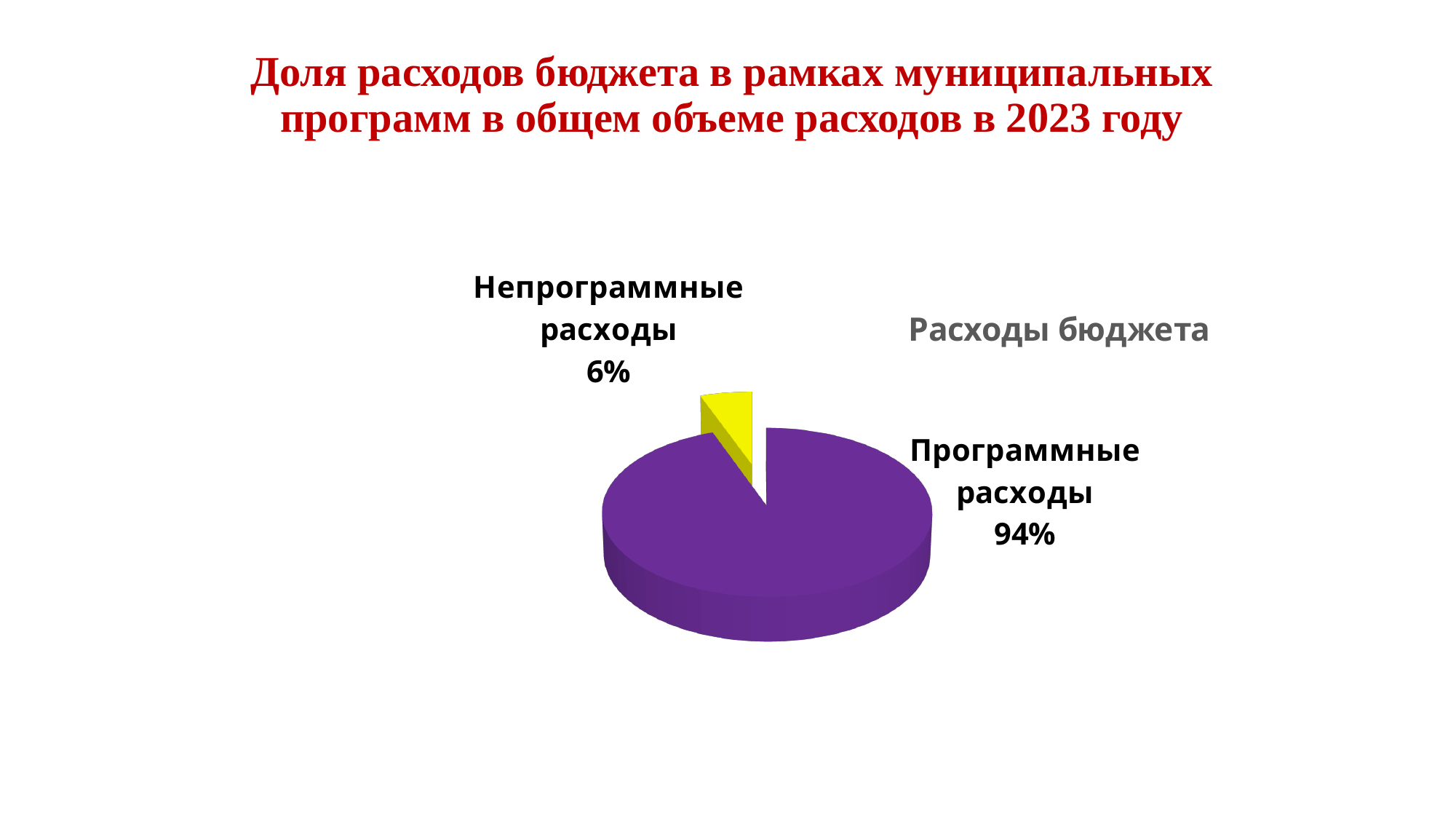
What is the total of the two slices shown in the pie chart? 100% Which slice of the pie is the largest? Программные расходы What share of the pie is labelled "Непрограммные расходы"? 6% How many slices does the pie chart have? 2 What colour is the slice for "Непрограммные расходы"? Yellow Which slice of the pie is the smallest? Непрограммные расходы What type of chart is shown on the slide? Pie chart Which is larger: the share for "Программные расходы" or the share for "Непрограммные расходы"? Программные расходы What share of the pie is labelled "Программные расходы"? 94% What is the difference in percentage points between "Программные расходы" and "Непрограммные расходы"? 88 percentage points What is the title of the chart? Расходы бюджета